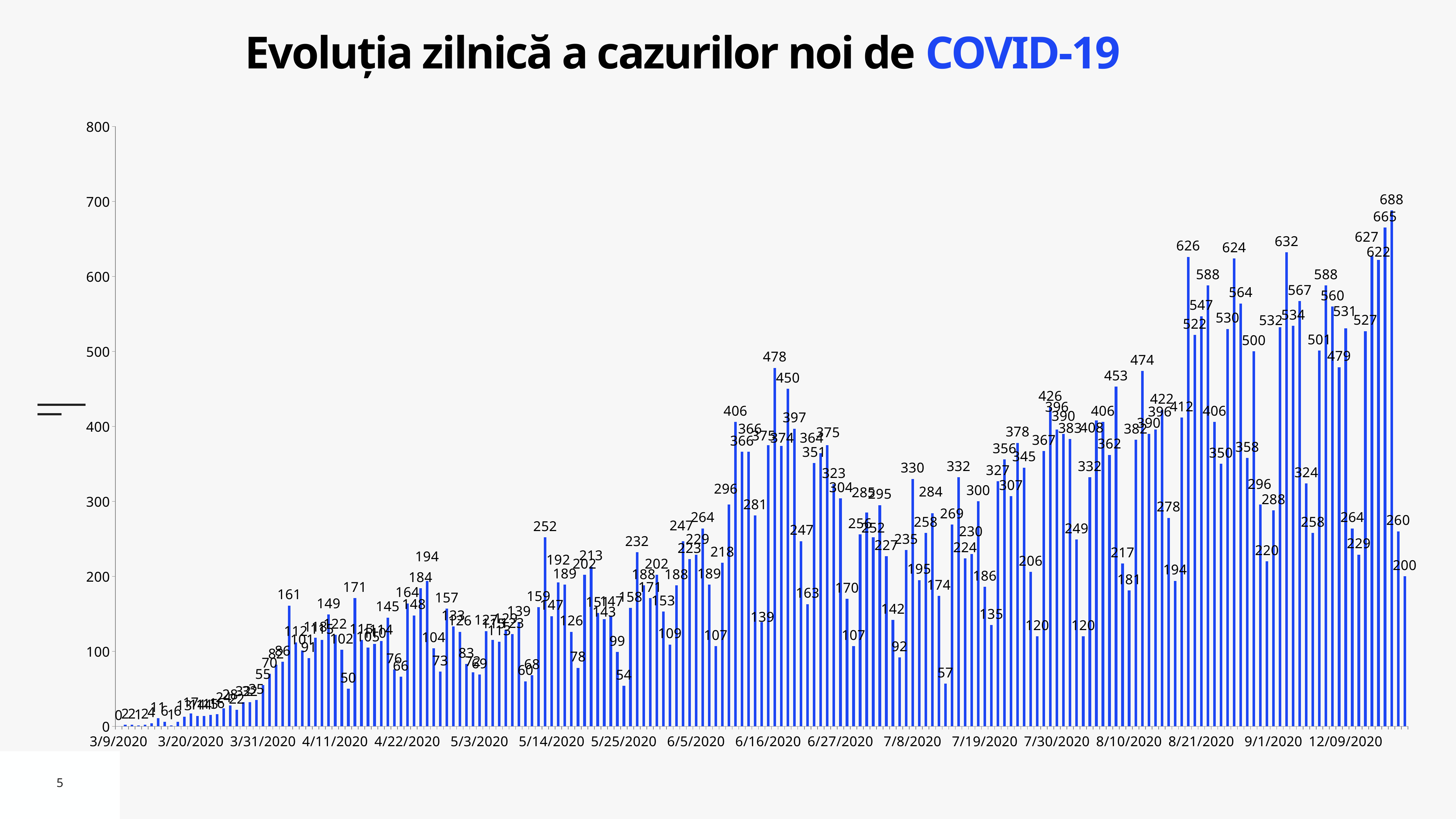
What is the difference between the highest value (688) and the second highest value (665)? 23 What is the value of the first bar, at 3/9/2020? 0 What kind of chart is shown on the slide? bar chart What is the difference between the highest value (688) and the value of the last bar (200)? 488 What is the title of the chart? Evoluția zilnică a cazurilor noi de COVID-19 Is the tallest bar in the chart greater or less than 600? greater What is the highest daily value shown in the chart? 688 What is the value of the last bar on the right of the chart? 200 Overall, do the daily values rise or fall from left to right along the x axis? rise What is the first date label on the x axis? 3/9/2020 Which is larger, the bar labelled 688 or the bar labelled 665? 688 What is the highest value shown on the y axis? 800